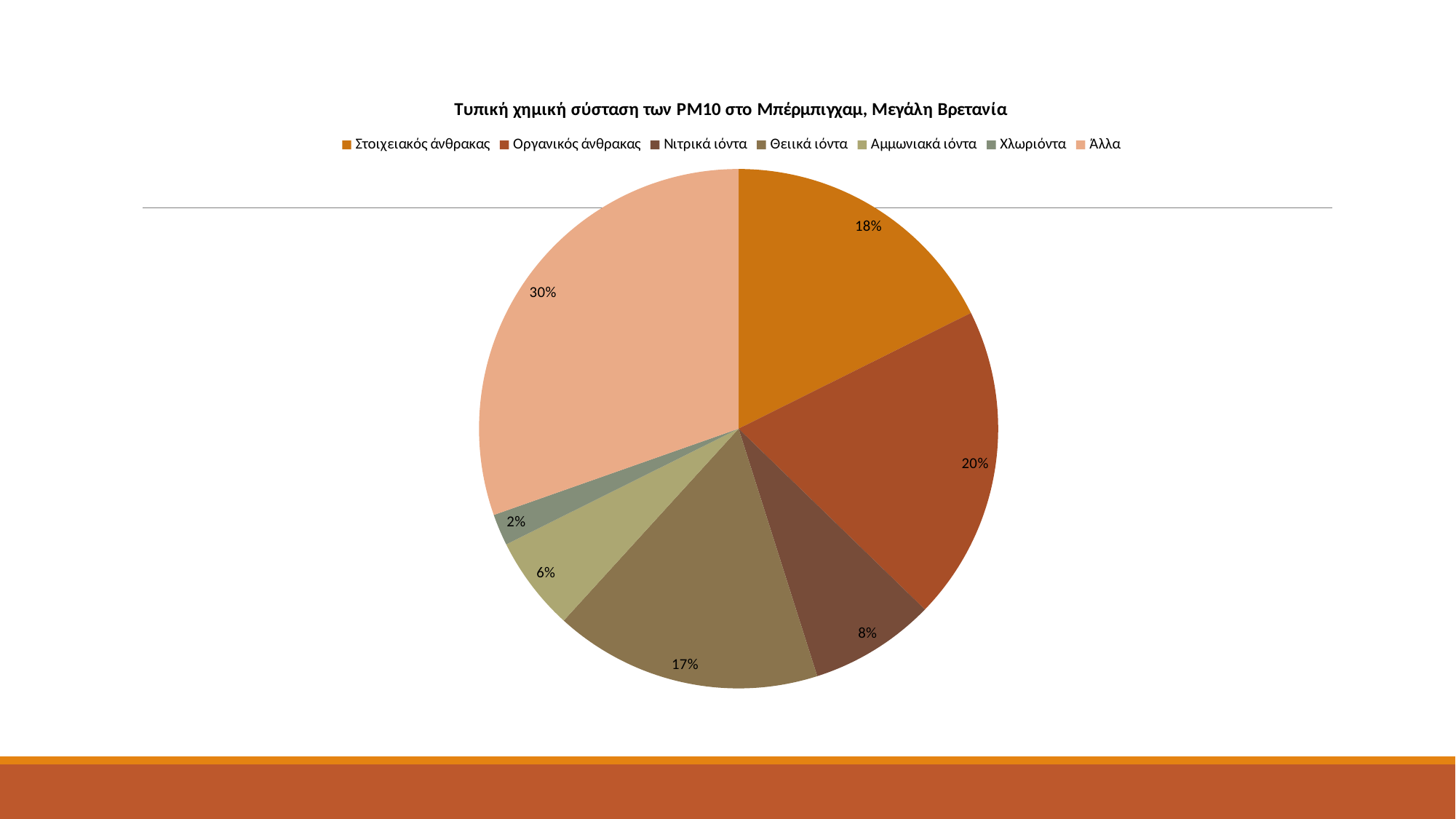
What share of the pie is Χλωριόντα? 2% Which category has the largest slice of the pie? Άλλα How many categories does the legend list? 7 What share of the pie is Στοιχειακός άνθρακας? 18% Which category has the smallest slice of the pie? Χλωριόντα What is the title of the chart? Τυπική χημική σύσταση των PM10 στο Μπέρμπιγχαμ, Μεγάλη Βρετανία Which is larger, the slice for Οργανικός άνθρακας or the slice for Θειικά ιόντα? Οργανικός άνθρακας What share of the pie is Νιτρικά ιόντα? 8% What is the difference in percentage points between Άλλα and Αμμωνιακά ιόντα? 24 What kind of chart is shown on the slide? Pie chart